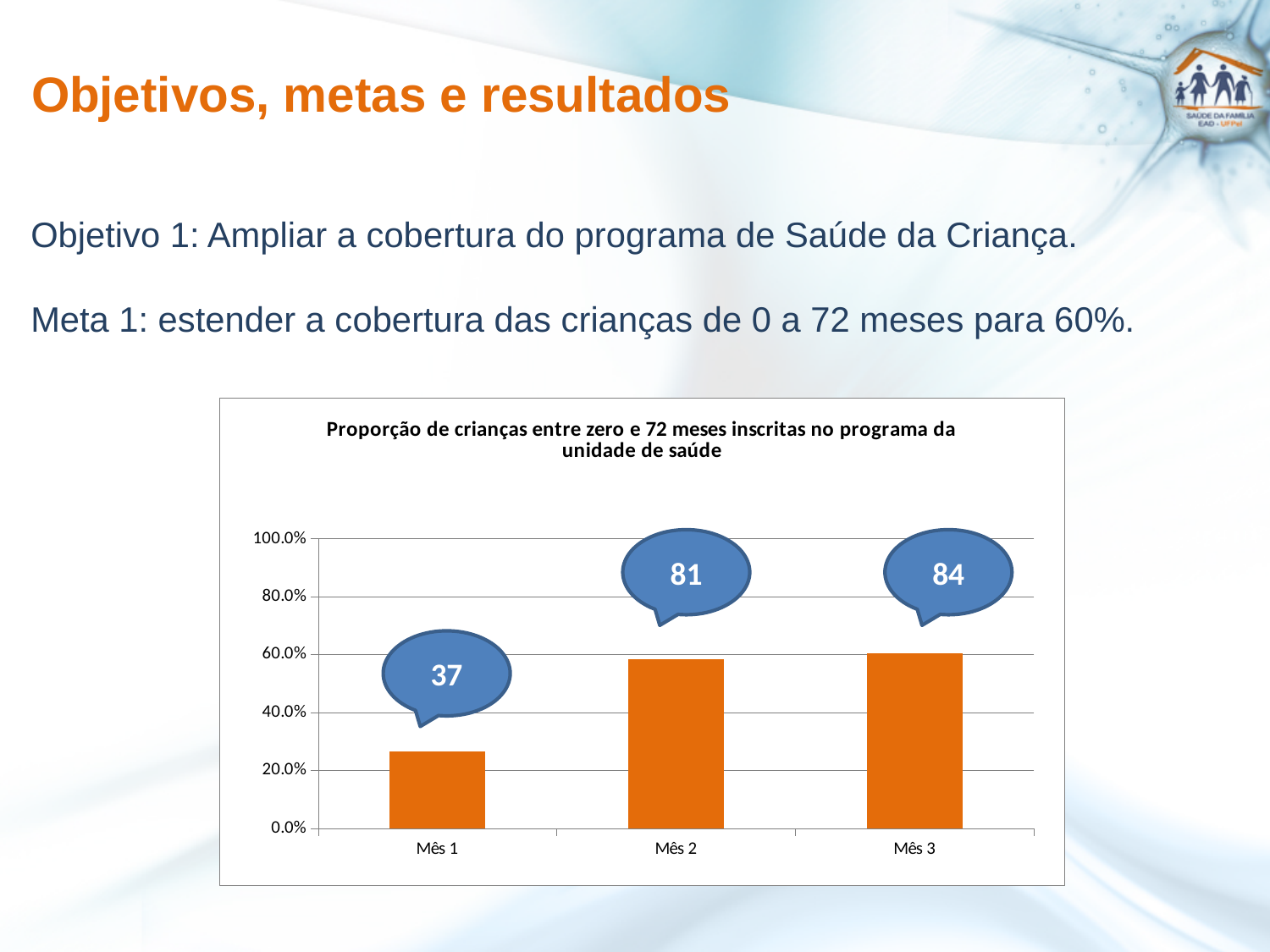
Which month has the lowest bar in the chart? Mês 1 What kind of chart is shown on the slide? bar chart Is the value for Mês 1 greater or less than 40.0%? less How many categories (months) are shown on the x axis of the chart? 3 Which bar is taller, Mês 1 or Mês 2? Mês 2 Which bar is taller, Mês 1 or Mês 3? Mês 3 Is the value for Mês 3 greater or less than 80.0%? less Do the bar values rise or fall from Mês 1 to Mês 3? rise What number is shown in the callout above the Mês 2 bar? 81 Is the value for Mês 2 greater or less than 40.0%? greater What is the title of the chart? Proporção de crianças entre zero e 72 meses inscritas no programa da unidade de saúde